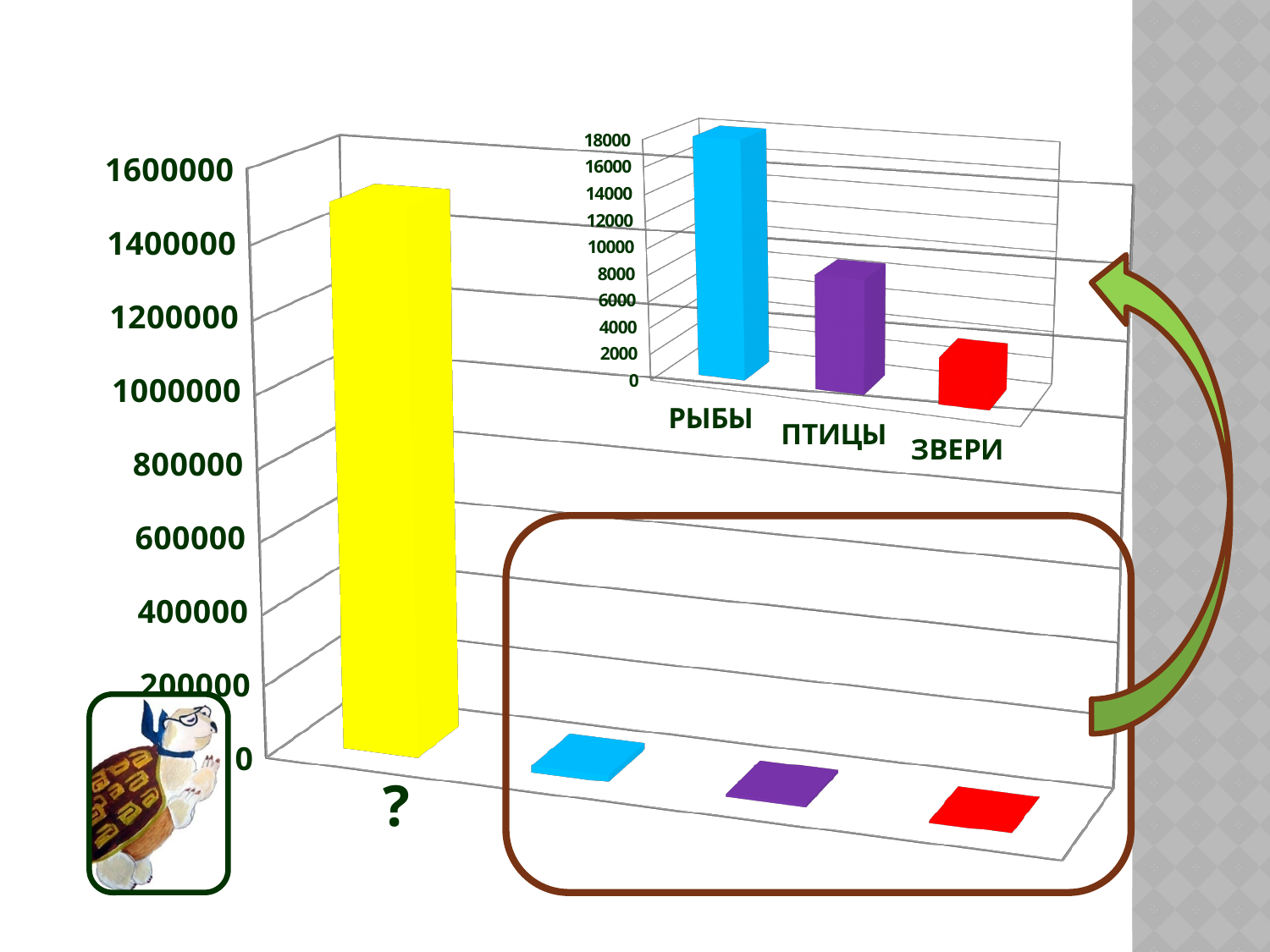
What kind of chart is the large chart on the left? bar chart In the inset chart (top right), is the value for РЫБЫ greater or less than 16000? greater In the inset chart (top right), which category has the lowest value? ЗВЕРИ In the large chart on the left, is the value of the yellow bar labelled "?" greater or less than 1400000? greater In the inset chart (top right), what colour is the bar for РЫБЫ? blue What kind of chart is the inset chart (top right)? bar chart In the inset chart (top right), which is larger, the value for РЫБЫ or the value for ПТИЦЫ? РЫБЫ How many categories are shown in the inset chart (top right)? 3 In the inset chart (top right), is the value for ПТИЦЫ greater or less than 10000? less In the inset chart (top right), which category has the highest value? РЫБЫ